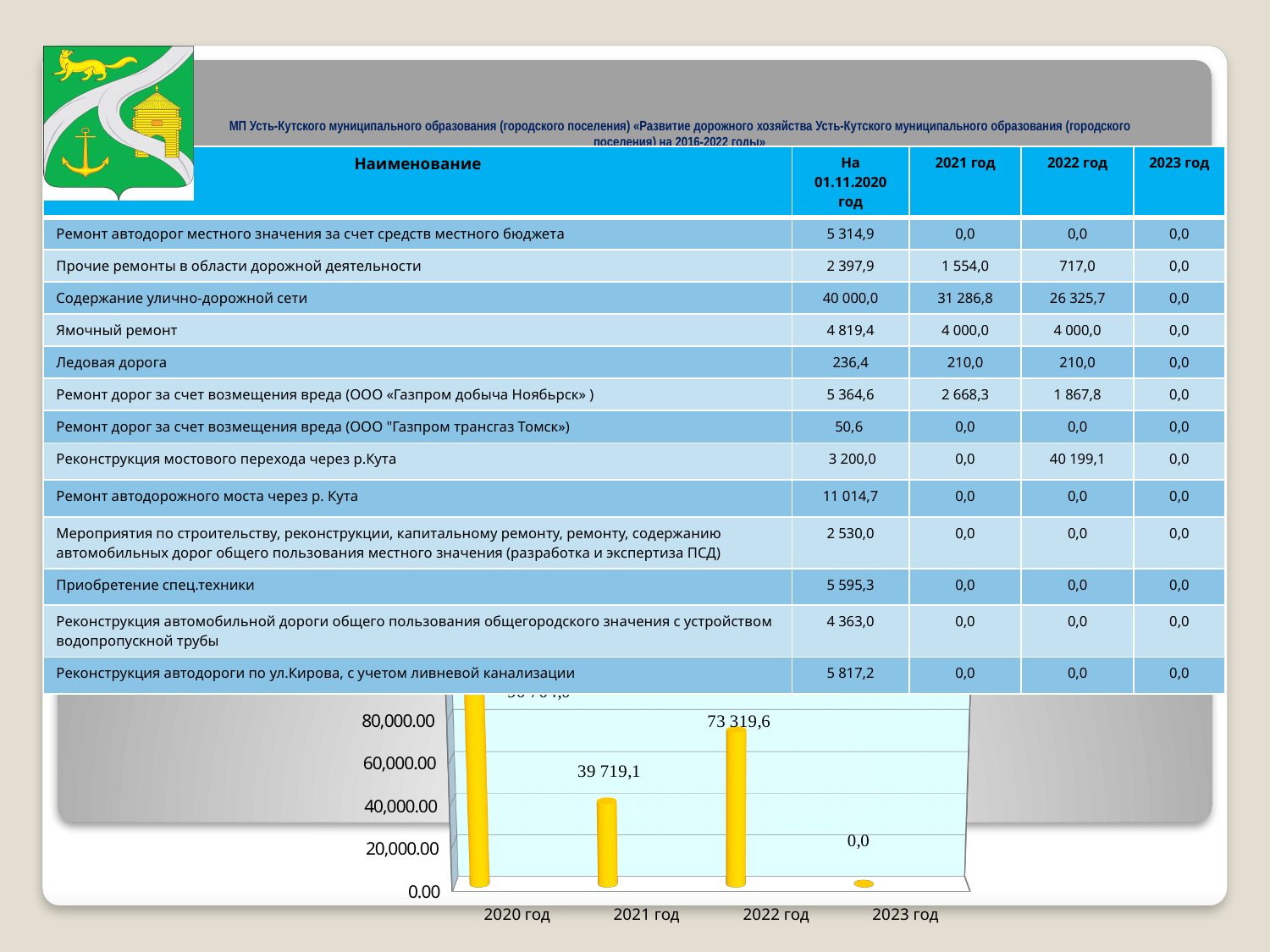
What is the highest tick label shown on the y axis of the bar chart? 80,000.00 In the bar chart, what is the value for 2023 год? 0,0 In the bar chart, what is the value for 2022 год? 73 319,6 In the bar chart, what is the value for 2021 год? 39 719,1 In the bar chart, which is larger: the value for 2021 год or the value for 2022 год? 2022 год In the bar chart, is the value for 2020 год greater or less than 80,000.00? greater In the bar chart, what is the difference between the values for 2022 год and 2021 год? 33 600,5 In the bar chart, is the value for 2022 год greater or less than 60,000.00? greater Which year has the tallest bar in the bar chart? 2020 год How many categories are shown on the x axis of the bar chart? 4 What kind of chart is shown at the bottom of the slide? bar chart Which year has the lowest value in the bar chart? 2023 год